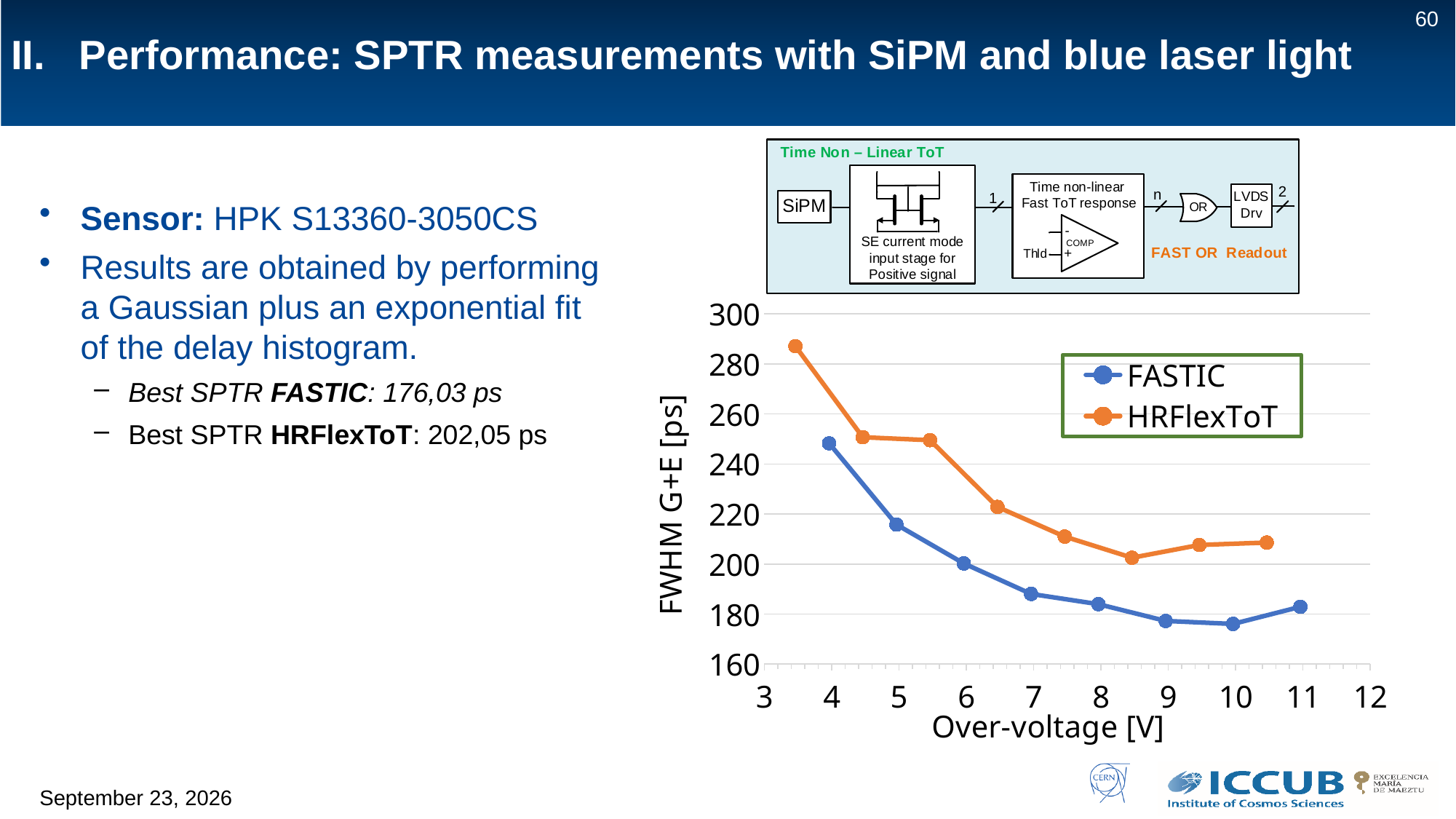
Is the FASTIC value at an over-voltage of 4 V greater or less than 240? greater Do the FASTIC values generally rise or fall as the over-voltage increases from 4 V to 10 V? fall Is the first HRFlexToT point (at about 3.5 V) greater or less than 280? greater Is the FASTIC value at an over-voltage of 10 V greater or less than 180? less Which two series are listed in the chart legend? FASTIC and HRFlexToT What is the label of the y axis of the chart? FWHM G+E [ps] How many data points are plotted for the HRFlexToT series? 8 How many data points are plotted for the FASTIC series? 8 What kind of chart is shown on the slide? line chart How many series does the chart legend list? 2 Which series has the higher FWHM values across the over-voltage range, FASTIC or HRFlexToT? HRFlexToT